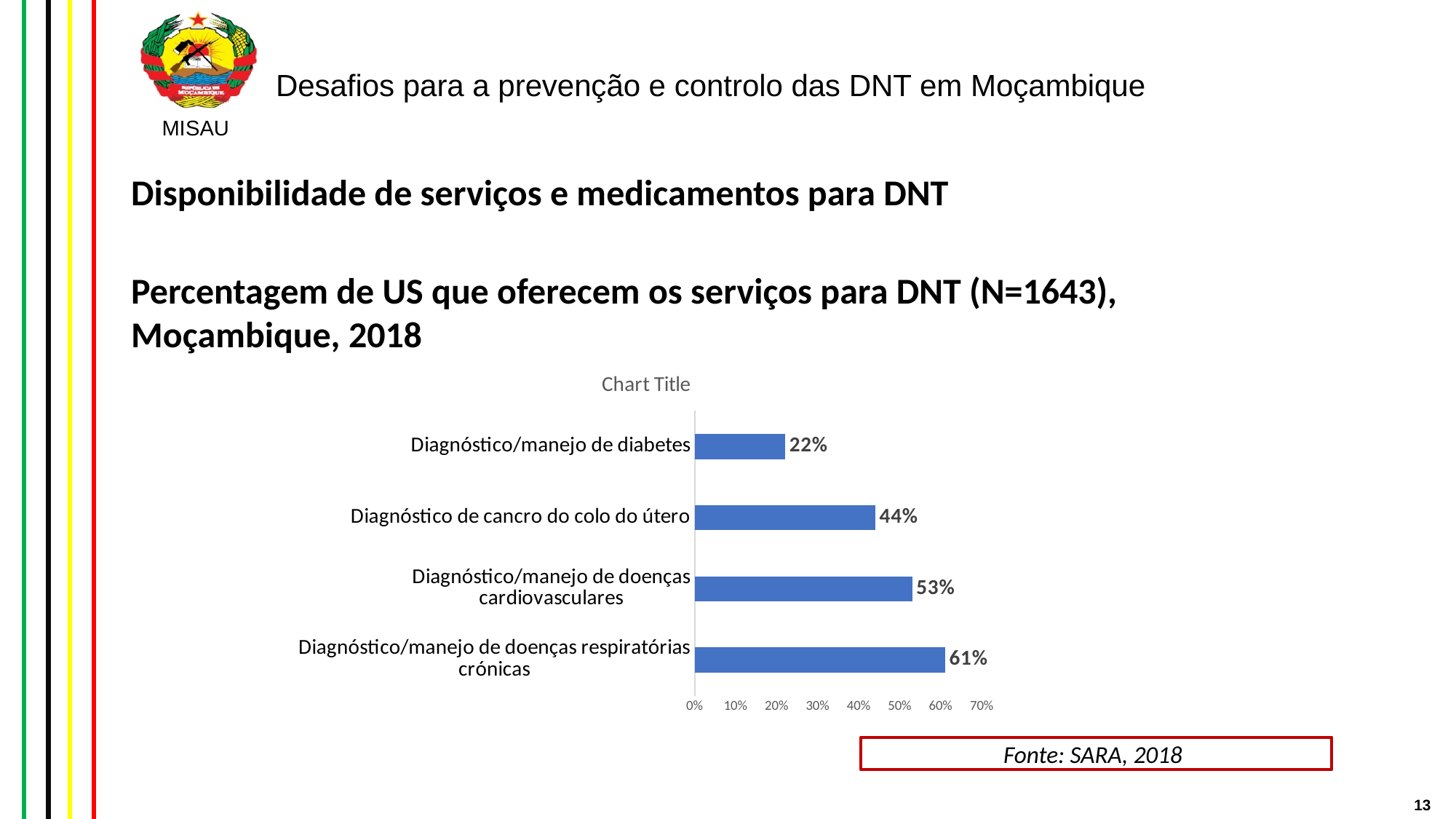
What percentage of health facilities offer Diagnóstico/manejo de diabetes? 22% What type of chart is shown on the slide? Bar chart Which service has the highest percentage of health facilities offering it? Diagnóstico/manejo de doenças respiratórias crónicas Which is larger: the value for Diagnóstico de cancro do colo do útero or for Diagnóstico/manejo de doenças cardiovasculares? Diagnóstico/manejo de doenças cardiovasculares How many service categories are shown in the chart? 4 What is the value shown for Diagnóstico de cancro do colo do útero? 44% What is the value shown for Diagnóstico/manejo de doenças cardiovasculares? 53% What is the difference in percentage points between Diagnóstico/manejo de doenças respiratórias crónicas and Diagnóstico/manejo de diabetes? 39 percentage points Is the value for Diagnóstico de cancro do colo do útero greater or less than 50%? less What is the value shown for Diagnóstico/manejo de doenças respiratórias crónicas? 61% Which service has the lowest percentage of health facilities offering it? Diagnóstico/manejo de diabetes What is the source cited for the chart data? SARA, 2018